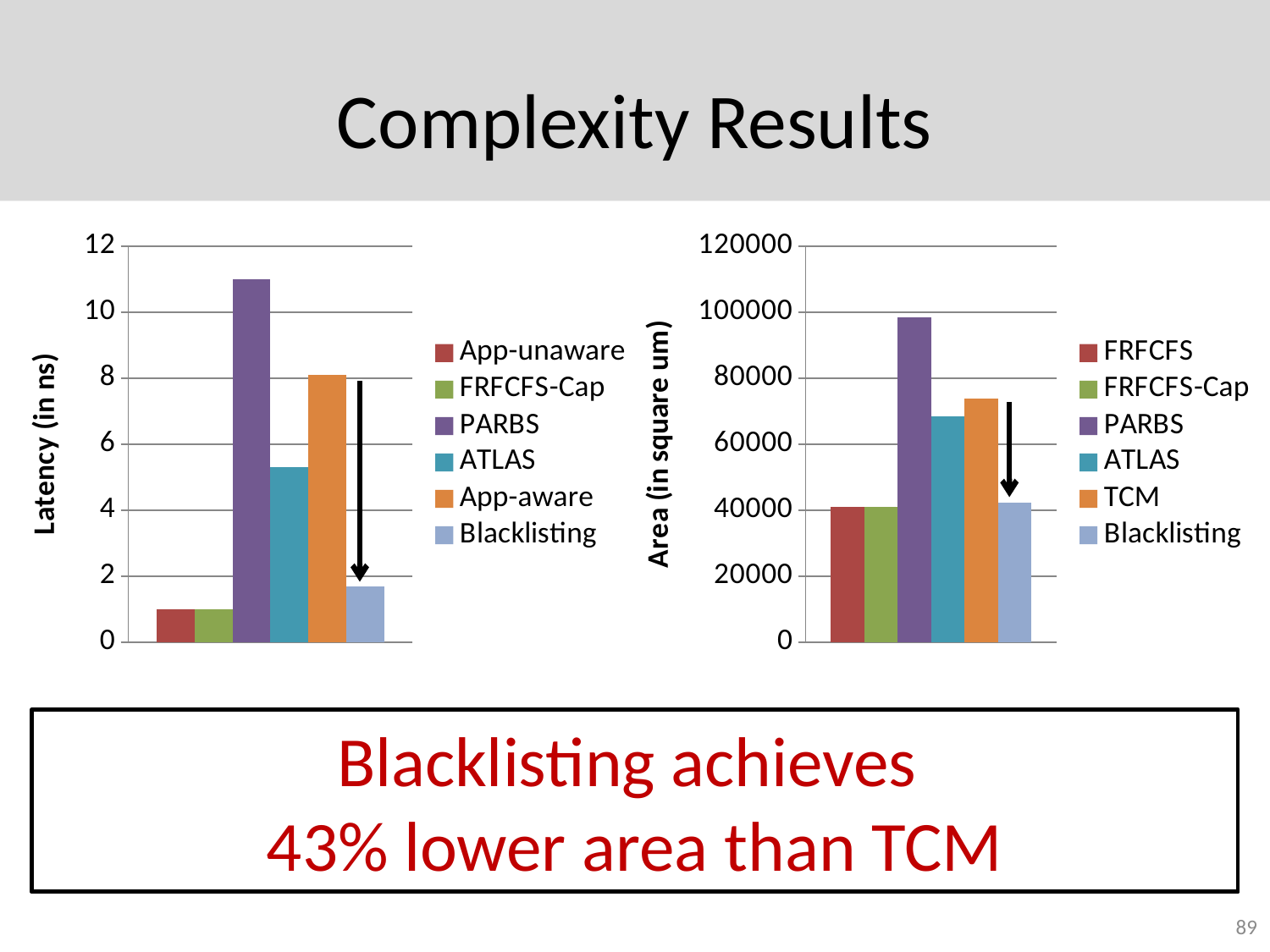
In the right chart (Area in square um), which series has the largest area? PARBS In the right chart (Area in square um), which is larger, the value for ATLAS or the value for Blacklisting? ATLAS In the right chart (Area in square um), is the value for Blacklisting greater or less than 60000? less In the right chart (Area in square um), is the value for TCM greater or less than 60000? greater In the left chart (Latency in ns), is the value for PARBS greater or less than 10? greater How many series does the legend of the left chart (Latency in ns) list? 6 In the left chart (Latency in ns), which series has the highest latency? PARBS What kind of chart is the left chart (Latency in ns)? bar chart What is the y-axis label of the right chart? Area (in square um) In the left chart (Latency in ns), which is larger, the value for App-aware or the value for ATLAS? App-aware How many series does the legend of the right chart (Area in square um) list? 6